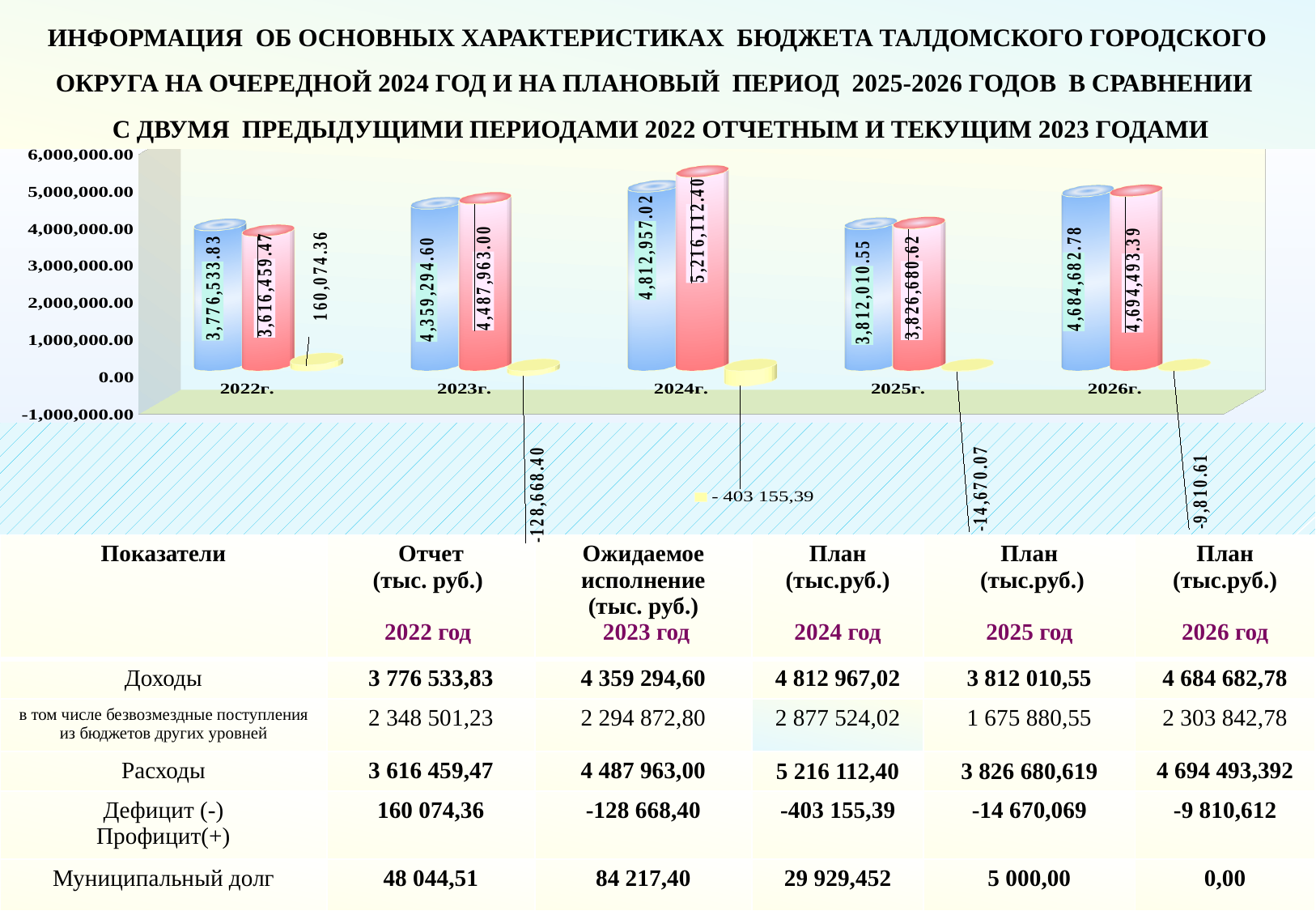
For 2025г., which is larger: the blue bar or the red bar? the red bar In which year is the red bar the highest? 2024г. What value is printed for the yellow (deficit) marker for 2023г.? -128,668.40 What kind of chart is shown on the slide? bar chart What is the value printed on the blue bar for 2025г.? 3,812,010.55 Do the blue bars rise or fall from 2022г. to 2024г.? rise How many year categories are shown on the x axis of the chart? 5 Is the value of the red bar for 2023г. greater or less than 4,000,000.00? greater What is the value printed on the blue bar for 2022г.? 3,776,533.83 In which year is the blue bar the lowest? 2022г. What is the difference between the blue bar and the red bar for 2022г.? 160,074.36 What is the value printed on the red bar for 2026г.? 4,694,493.39